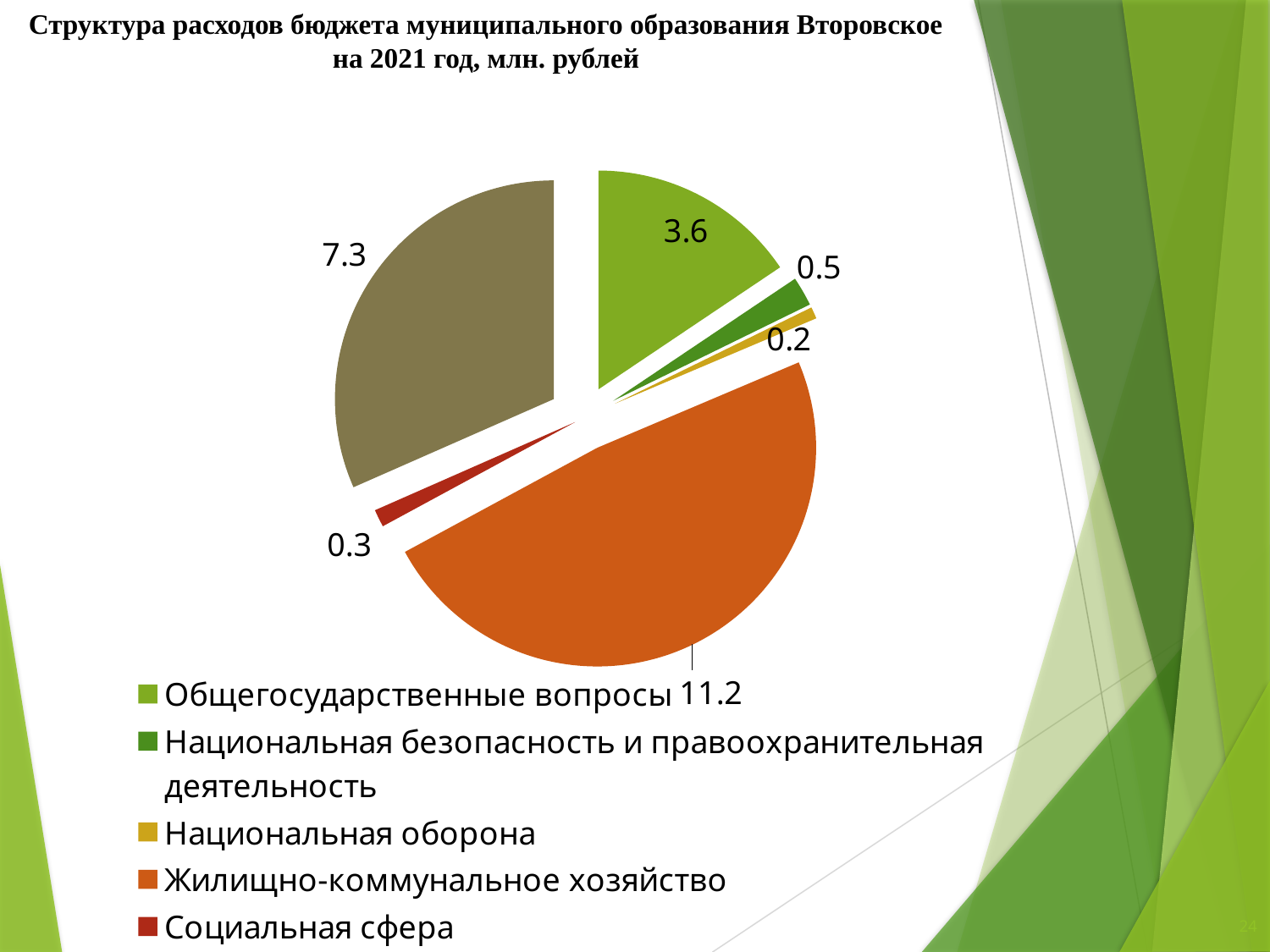
What kind of chart is shown on the slide? pie chart How many entries does the legend list? 5 Which category has the smallest slice of the pie? Национальная оборона What is the value for Национальная оборона? 0.2 Which category has the largest slice of the pie? Жилищно-коммунальное хозяйство What is the value for Жилищно-коммунальное хозяйство? 11.2 What is the difference between the values for Жилищно-коммунальное хозяйство and Общегосударственные вопросы? 7.6 What is the value for Общегосударственные вопросы? 3.6 What is the value for Национальная безопасность и правоохранительная деятельность? 0.5 Which is larger: the value for Национальная безопасность и правоохранительная деятельность or the value for Социальная сфера? Национальная безопасность и правоохранительная деятельность What is the value for Социальная сфера? 0.3 How many slices does the pie chart have? 6